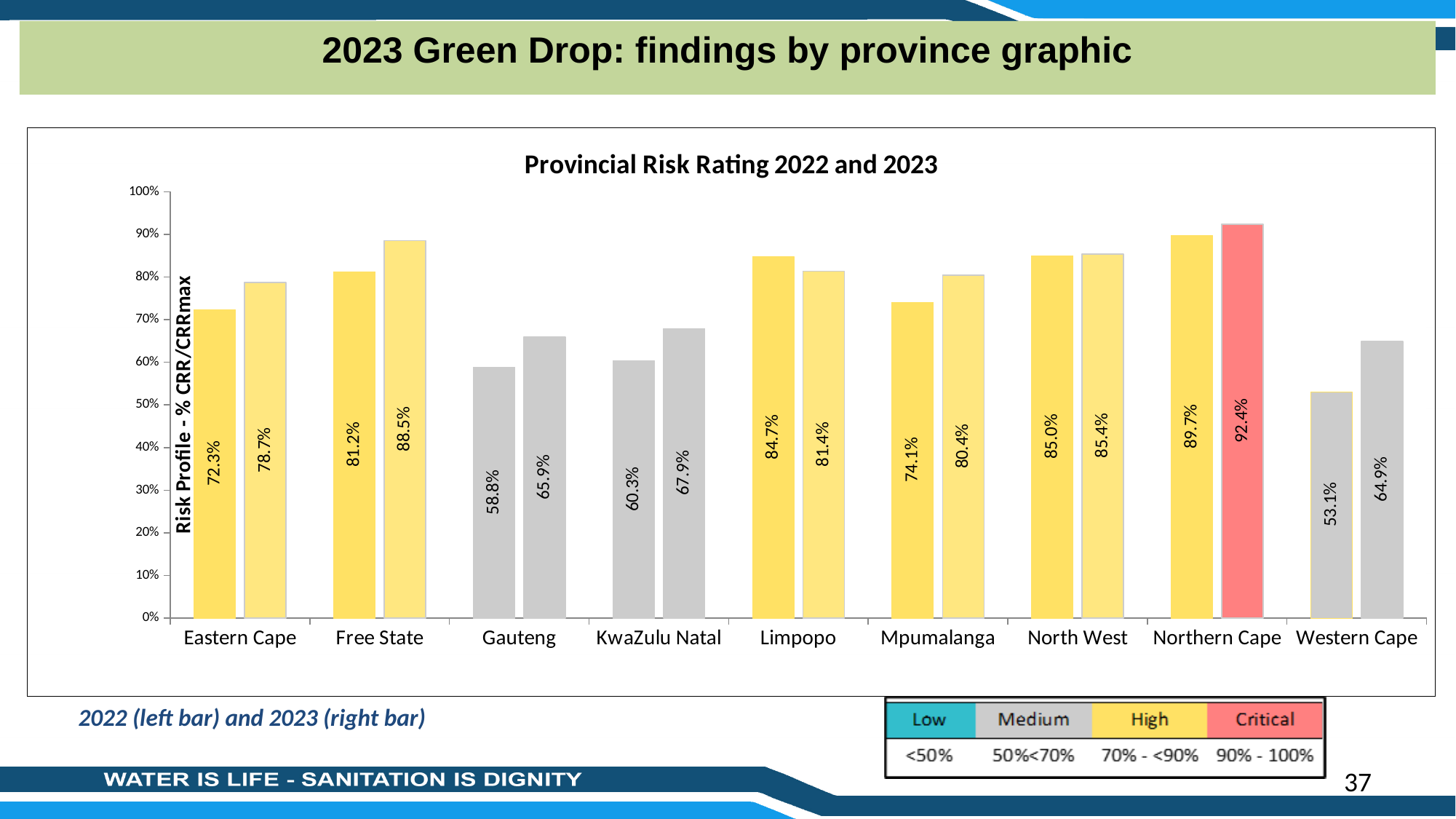
What is the 2023 risk rating for Western Cape? 64.9% By how many percentage points did Free State's risk rating change from 2022 to 2023? 7.3 percentage points Which risk category does the red colour of Northern Cape's 2023 bar represent according to the legend? Critical Which province has the lowest 2022 risk rating? Western Cape What is the difference between Western Cape's 2023 and 2022 risk ratings? 11.8 percentage points What type of chart is shown on the slide? Bar chart Which province has the highest 2023 risk rating? Northern Cape What is the title of the chart? Provincial Risk Rating 2022 and 2023 What is the 2023 risk rating for Free State? 88.5% How many provinces are shown on the x axis? 9 What is the 2022 risk rating for Gauteng? 58.8% For Limpopo, which year has the higher risk rating, 2022 or 2023? 2022